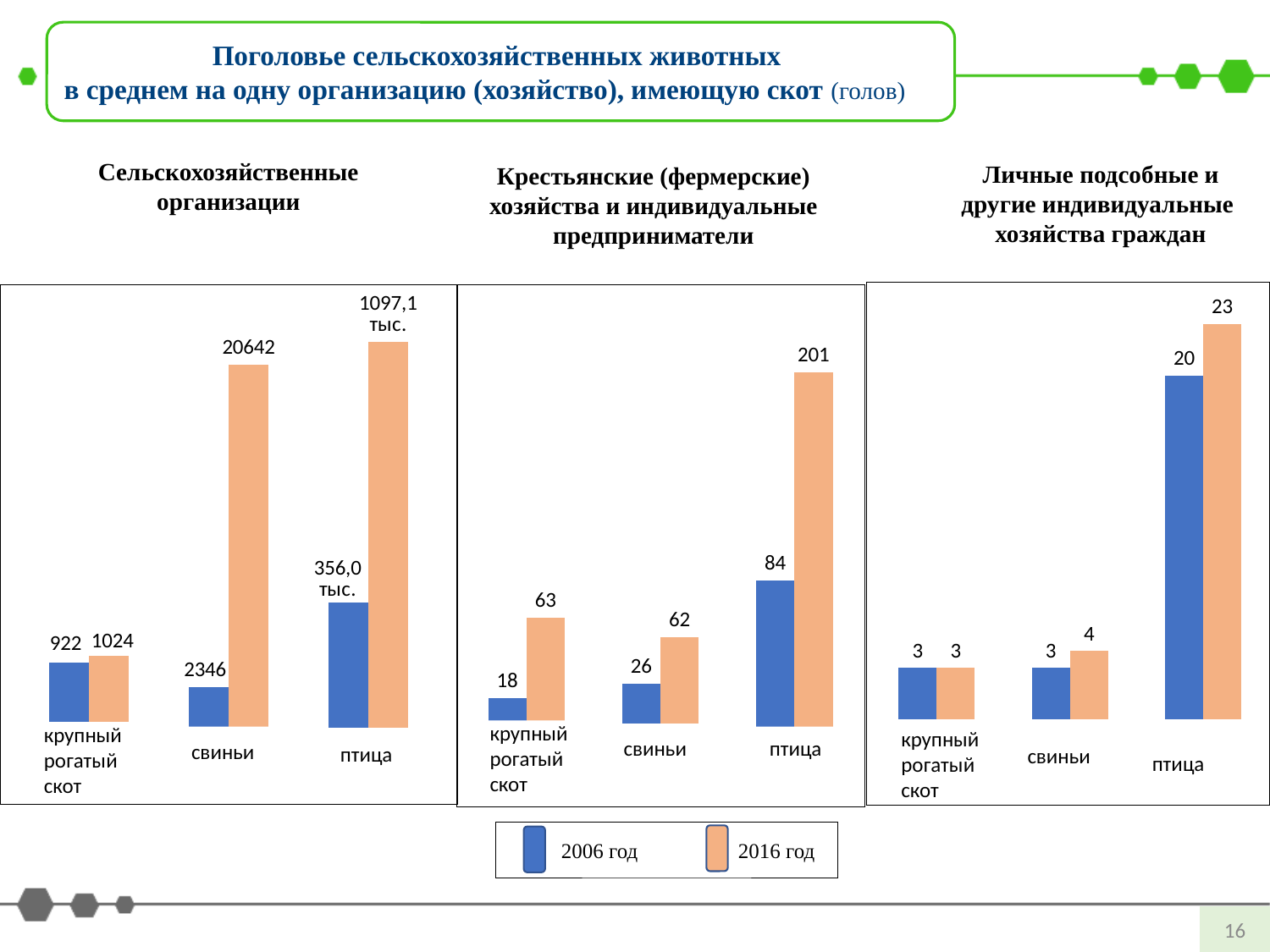
How many series does the legend list? 2 In the chart 'Личные подсобные и другие индивидуальные хозяйства граждан', which category has the highest value in 2016 год? птица In the chart 'Сельскохозяйственные организации', what is the value for птица in 2006 год? 356,0 тыс. In the chart 'Личные подсобные и другие индивидуальные хозяйства граждан', what is the value for свиньи in 2016 год? 4 In the chart 'Крестьянские (фермерские) хозяйства и индивидуальные предприниматели', what is the difference between the 2016 год and 2006 год values for птица? 117 In the chart 'Крестьянские (фермерские) хозяйства и индивидуальные предприниматели', what is the value for птица in 2016 год? 201 In the chart 'Сельскохозяйственные организации', what is the difference between the 2016 год and 2006 год values for крупный рогатый скот? 102 In the chart 'Крестьянские (фермерские) хозяйства и индивидуальные предприниматели', which category has the lowest value in 2006 год? крупный рогатый скот How many categories are shown on the x axis of the chart 'Сельскохозяйственные организации'? 3 What type of chart is used in the chart 'Крестьянские (фермерские) хозяйства и индивидуальные предприниматели'? bar chart In the chart 'Сельскохозяйственные организации', what is the value for свиньи in 2016 год? 20642 In the chart 'Личные подсобные и другие индивидуальные хозяйства граждан', which is larger for птица: the 2006 год value or the 2016 год value? 2016 год